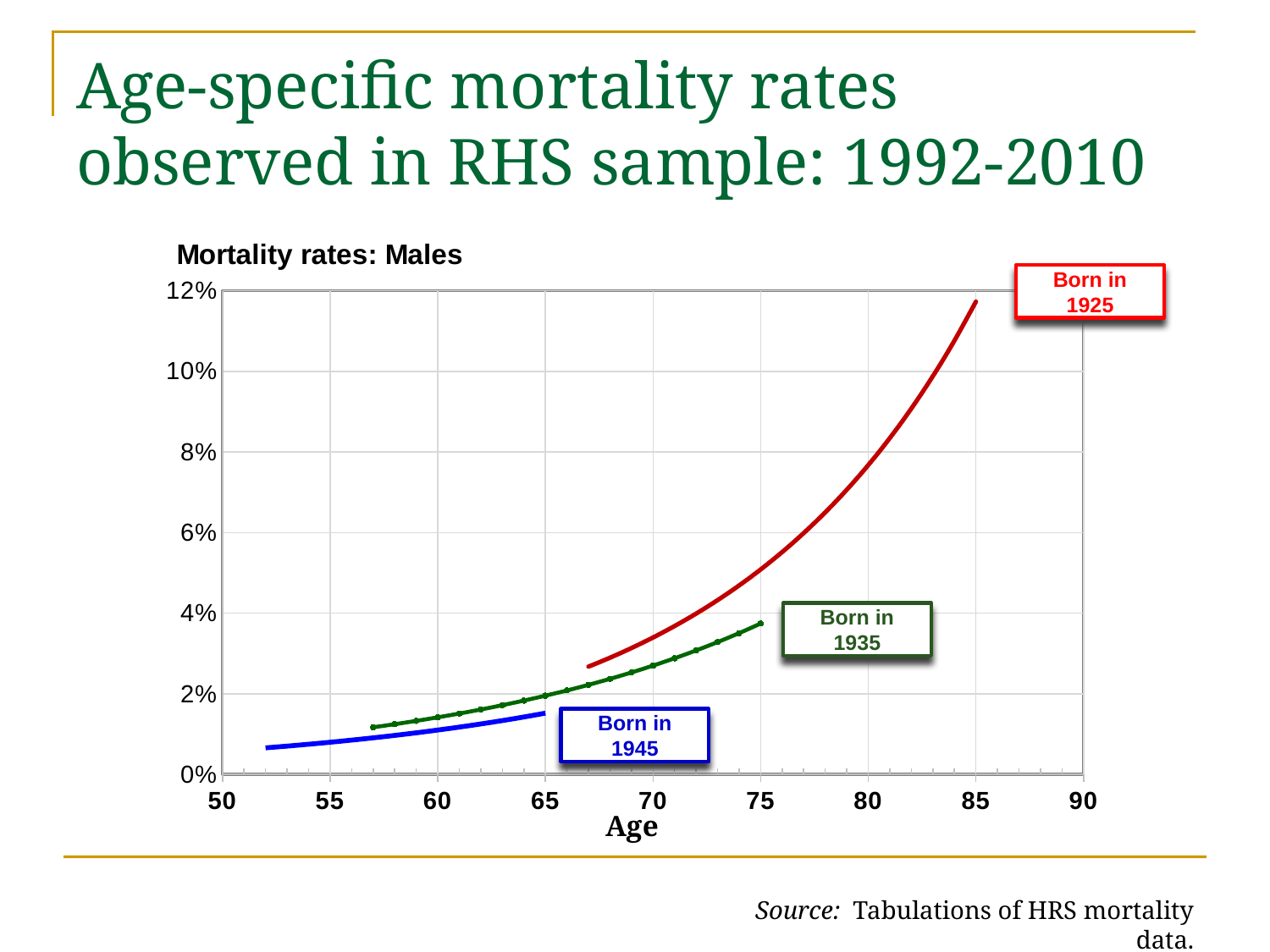
Do the mortality rates rise or fall as age increases along the x axis? Rise At age 70, which cohort has the higher mortality rate, Born in 1925 or Born in 1935? Born in 1925 Is the mortality rate for the Born in 1945 cohort at age 65 greater or less than 2%? less Is the mortality rate for the Born in 1925 cohort at age 70 greater or less than 2%? greater Is the mortality rate for the Born in 1925 cohort at age 85 greater or less than 10%? greater How many birth cohorts (series) are plotted on the chart? 3 What is the title of the chart? Mortality rates: Males What is the label of the x axis? Age At age 60, which cohort has the higher mortality rate, Born in 1935 or Born in 1945? Born in 1935 What kind of chart is shown on the slide? Line chart Which birth cohort reaches the highest mortality rate on the chart? Born in 1925